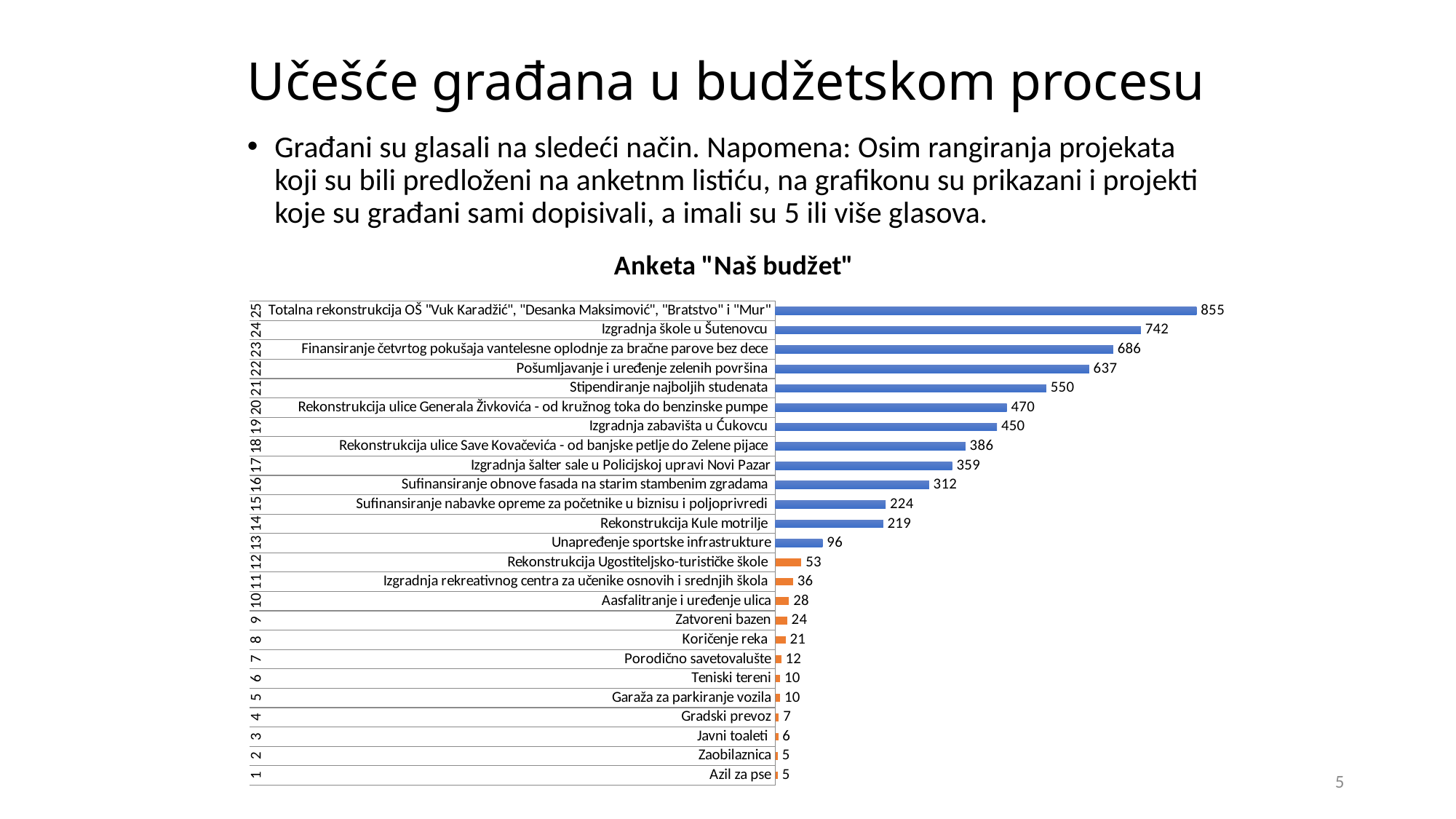
What is the value for "Zatvoreni bazen"? 24 What kind of chart is shown on the slide? Bar chart What colour are the bars for the categories with values of 53 or less? Orange What is the difference between the values for "Sufinansiranje nabavke opreme za početnike u biznisu i poljoprivredi" and "Rekonstrukcija Kule motrilje"? 5 Which is larger, the value for "Izgradnja zabavišta u Ćukovcu" or the value for "Rekonstrukcija ulice Save Kovačevića - od banjske petlje do Zelene pijace"? Izgradnja zabavišta u Ćukovcu What is the value for "Rekonstrukcija Kule motrilje"? 219 What is the value for "Stipendiranje najboljih studenata"? 550 Which category has the highest value? Totalna rekonstrukcija OŠ "Vuk Karadžić", "Desanka Maksimović", "Bratstvo" i "Mur" How many categories are shown in the chart? 25 What is the difference between the values for "Izgradnja škole u Šutenovcu" and "Pošumljavanje i uređenje zelenih površina"? 105 What is the title of the chart? Anketa "Naš budžet" What is the value for "Izgradnja škole u Šutenovcu"? 742